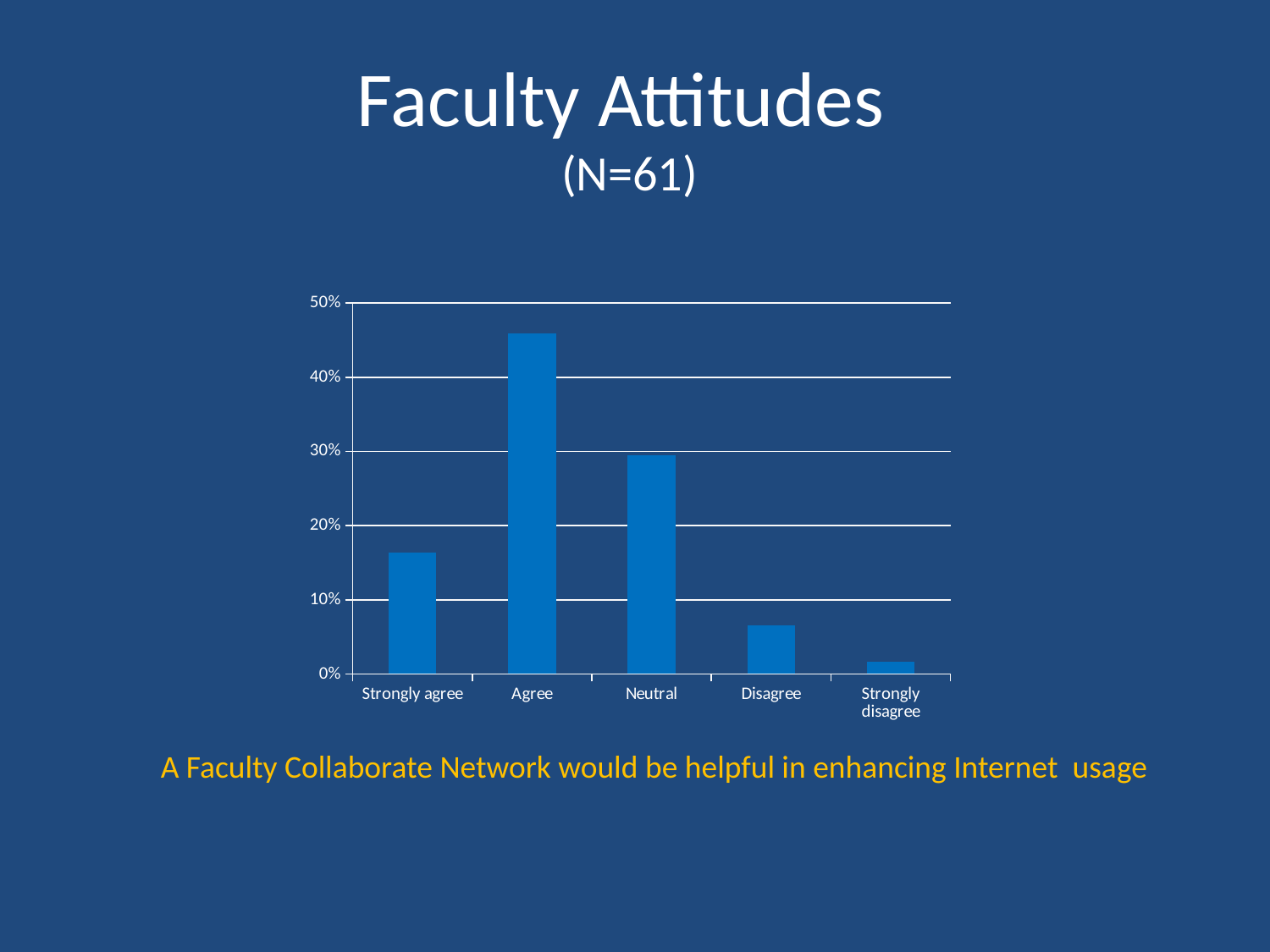
Which category has the highest value in the chart? Agree Which is larger, the value for Neutral or the value for Strongly agree? Neutral Is the value for Neutral greater or less than 20%? greater Is the value for Strongly agree greater or less than 10%? greater How many categories are shown on the x axis of the chart? 5 Which category has the lowest value in the chart? Strongly disagree Is the value for Agree greater or less than 40%? greater Which is larger, the value for Disagree or the value for Strongly disagree? Disagree What kind of chart is shown on the slide? bar chart What is the sample size (N) stated in the slide title? N=61